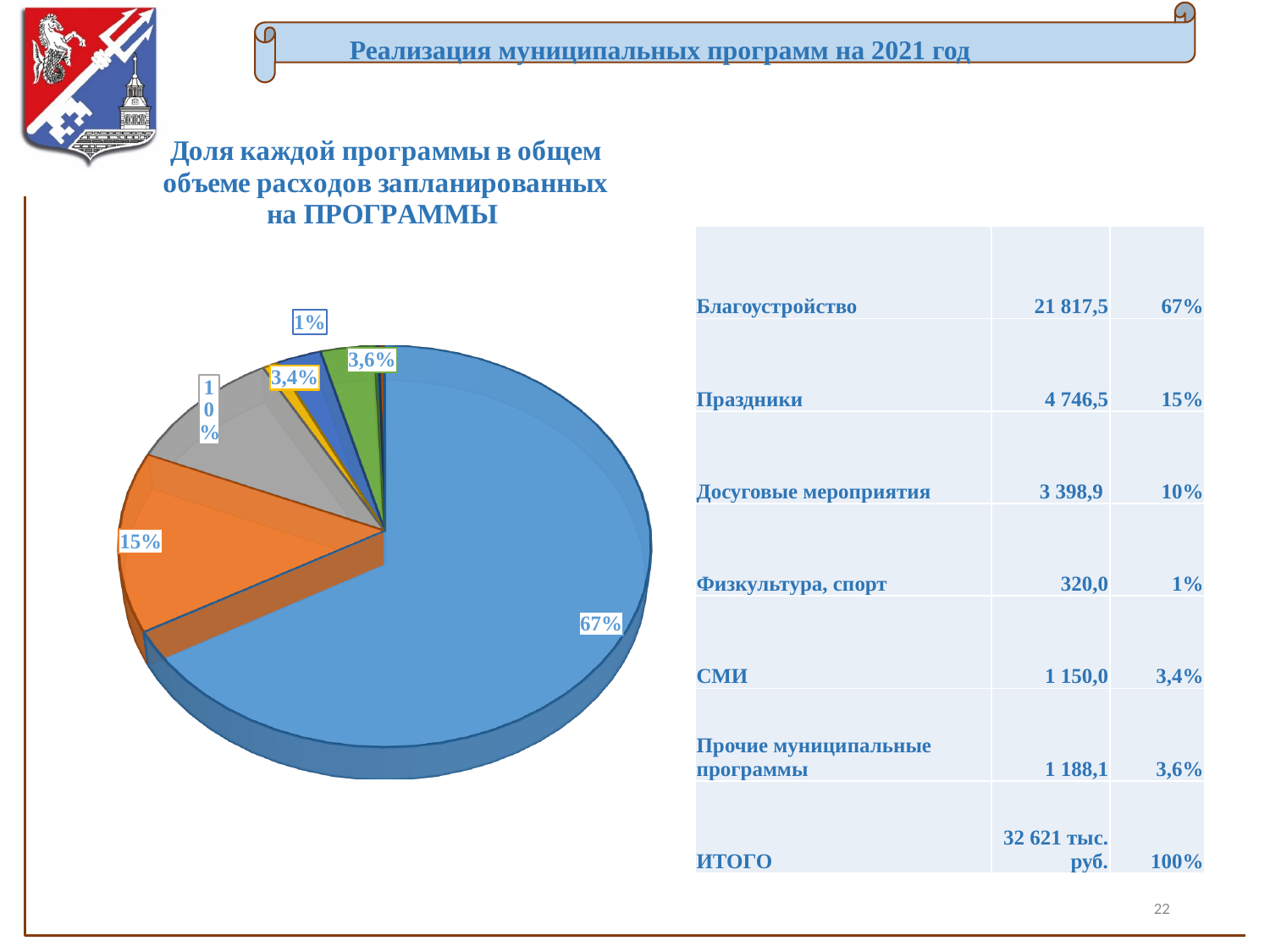
What is the smallest share shown on the pie chart? 1% What share of the pie chart does Досуговые мероприятия account for? 10% What share of the pie chart does СМИ account for? 3,4% What is the largest share shown on the pie chart? 67% What kind of chart is shown on the slide? Pie chart By how many percentage points does the share of Благоустройство exceed the share of Праздники? 52 Which program has the smallest share of planned program expenses? Физкультура, спорт Which share is larger on the pie chart: СМИ or Прочие муниципальные программы? Прочие муниципальные программы What share of the pie chart does Праздники account for? 15% Which program has the largest share of planned program expenses? Благоустройство What is the title of the pie chart? Доля каждой программы в общем объеме расходов запланированных на ПРОГРАММЫ